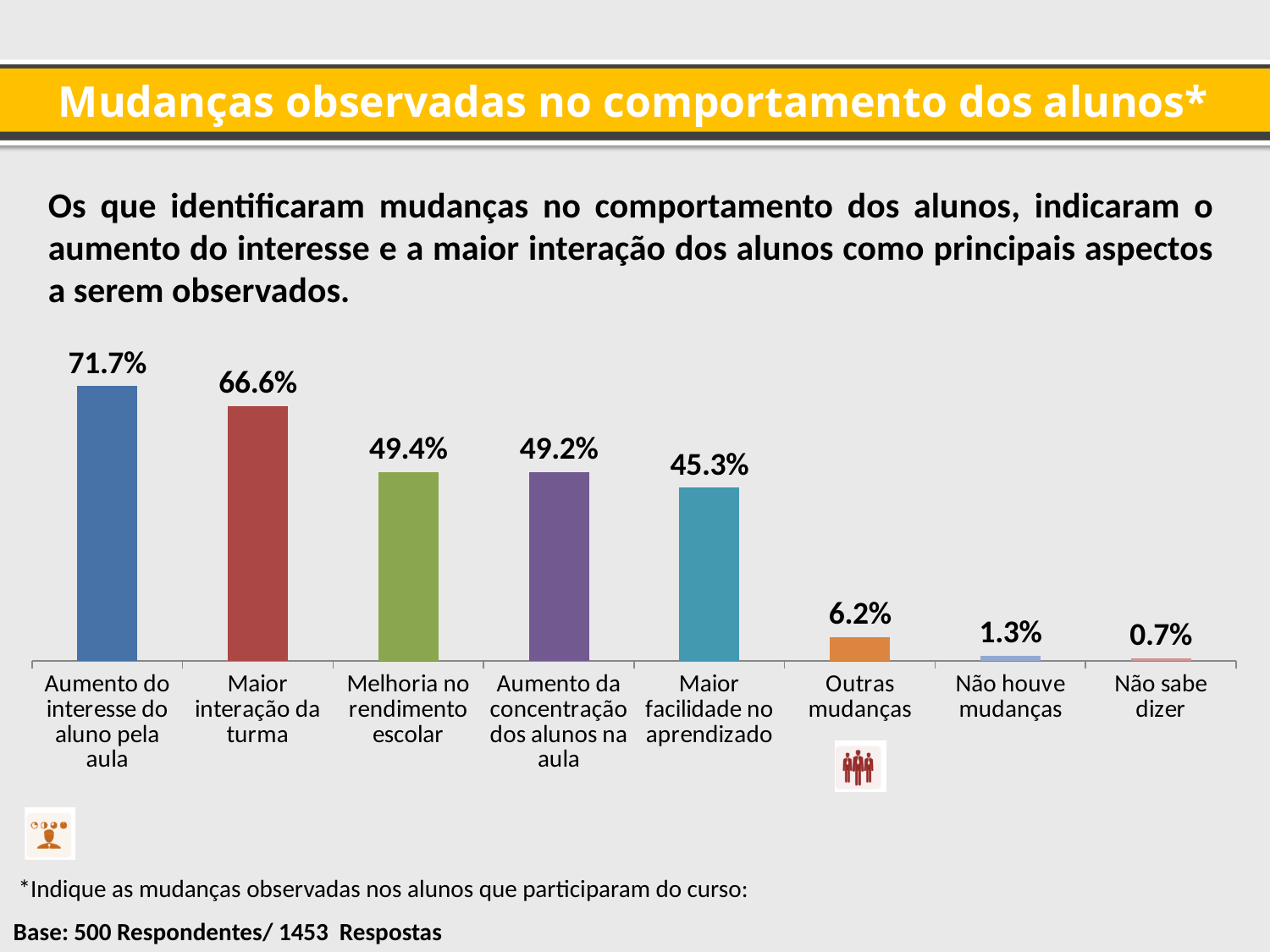
Which category has the lowest value? Não sabe dizer Do the values rise or fall from left to right across the categories? Fall Which is larger: "Melhoria no rendimento escolar" or "Maior facilidade no aprendizado"? Melhoria no rendimento escolar How many categories are shown in the chart? 8 Which category has the highest value? Aumento do interesse do aluno pela aula What is the value for "Não houve mudanças"? 1.3% What is the value for "Maior interação da turma"? 66.6% What percentage is shown for "Aumento do interesse do aluno pela aula"? 71.7% What is the difference between "Aumento do interesse do aluno pela aula" and "Maior interação da turma"? 5.1 percentage points What percentage is shown for "Maior facilidade no aprendizado"? 45.3% What kind of chart is shown on the slide? Bar chart What is the difference between "Outras mudanças" and "Não houve mudanças"? 4.9 percentage points